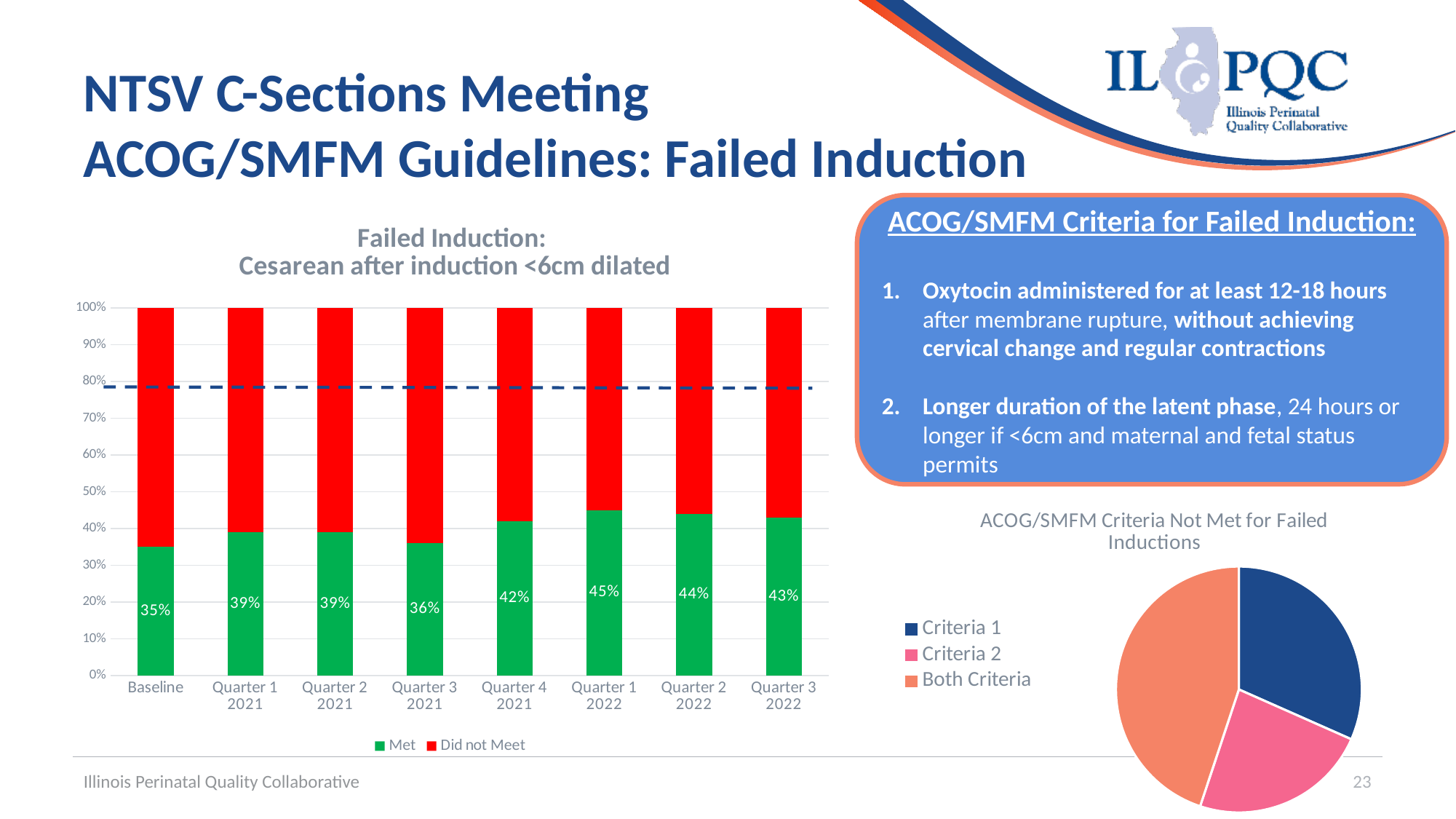
In the 'Failed Induction: Cesarean after induction <6cm dilated' chart, how many series does the legend list? 2 What kind of chart is the 'Failed Induction: Cesarean after induction <6cm dilated' chart? Stacked bar chart In the 'Failed Induction: Cesarean after induction <6cm dilated' chart, which period has the lowest Met value? Baseline In the 'ACOG/SMFM Criteria Not Met for Failed Inductions' pie chart, which slice is the largest? Both Criteria In the 'Failed Induction: Cesarean after induction <6cm dilated' chart, how many periods are shown on the x axis? 8 In the 'Failed Induction: Cesarean after induction <6cm dilated' chart, what is the Met value for Baseline? 35% In the 'ACOG/SMFM Criteria Not Met for Failed Inductions' pie chart, how many slices are there? 3 In the 'Failed Induction: Cesarean after induction <6cm dilated' chart, what is the difference between the Met value for Quarter 1 2022 and the Met value for Baseline? 10% In the 'Failed Induction: Cesarean after induction <6cm dilated' chart, which is larger: the Met value for Quarter 4 2021 or the Met value for Quarter 3 2021? Quarter 4 2021 In the 'Failed Induction: Cesarean after induction <6cm dilated' chart, which period has the highest Met value? Quarter 1 2022 In the 'Failed Induction: Cesarean after induction <6cm dilated' chart, what is the Met value for Quarter 1 2022? 45% In the 'Failed Induction: Cesarean after induction <6cm dilated' chart, what is the Met value for Quarter 3 2021? 36%